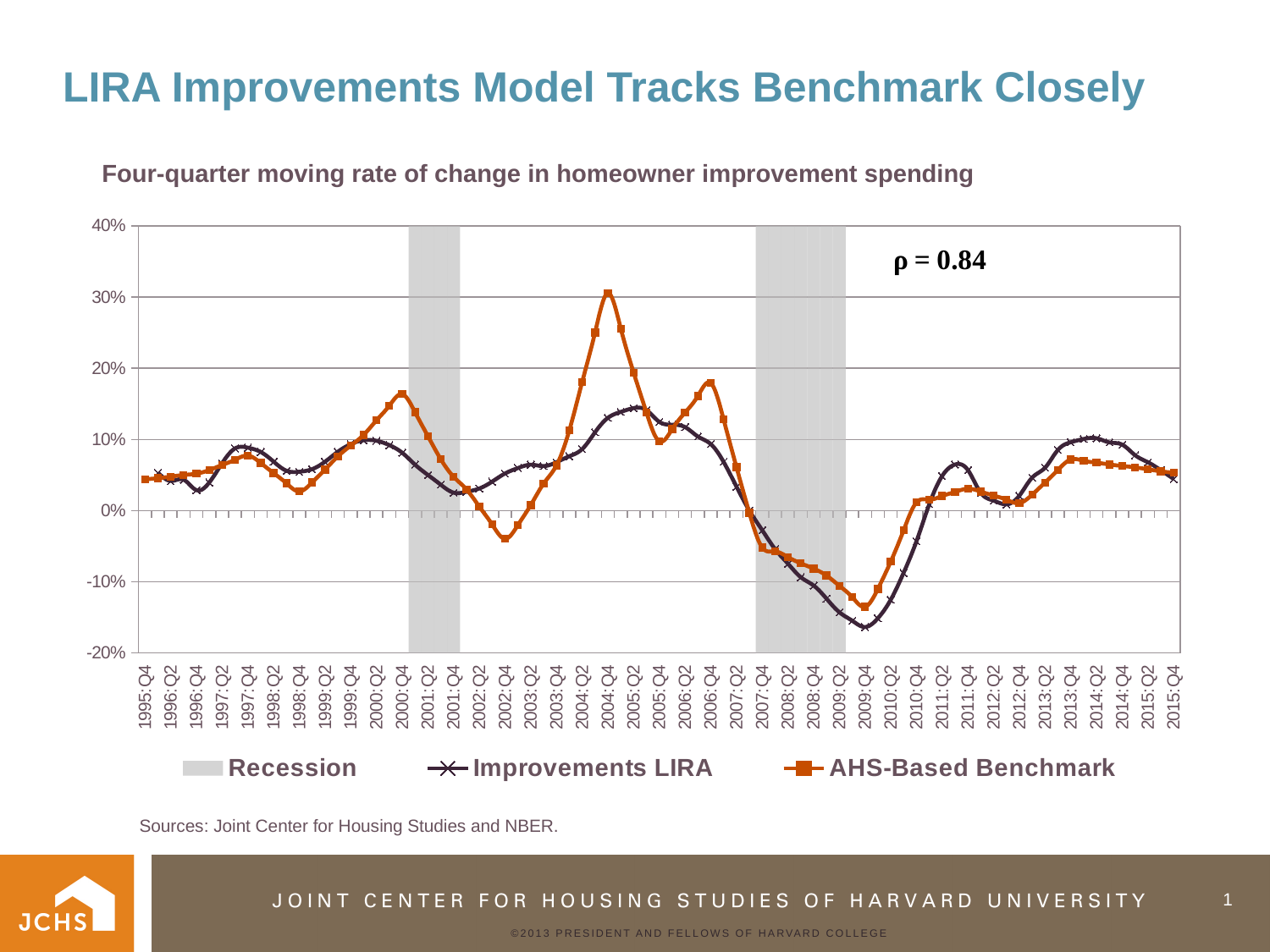
Which series reaches the highest peak on the chart? AHS-Based Benchmark Is the value for AHS-Based Benchmark at 2002:Q4 greater or less than 0%? less How many shaded recession periods are shown on the chart? 2 What correlation value is printed on the chart? ρ = 0.84 Is the value for Improvements LIRA at 2009:Q4 greater or less than -10%? less What kind of chart is shown on the slide? Line chart Is the value for AHS-Based Benchmark at 2004:Q4 greater or less than 20%? greater At 2004:Q4, which series has the higher value, Improvements LIRA or AHS-Based Benchmark? AHS-Based Benchmark How many entries does the chart legend list? 3 Does the AHS-Based Benchmark rise or fall between 2007:Q2 and 2009:Q4? fall Which series reaches the lowest point on the chart? Improvements LIRA At 2002:Q4, which series has the higher value, Improvements LIRA or AHS-Based Benchmark? Improvements LIRA